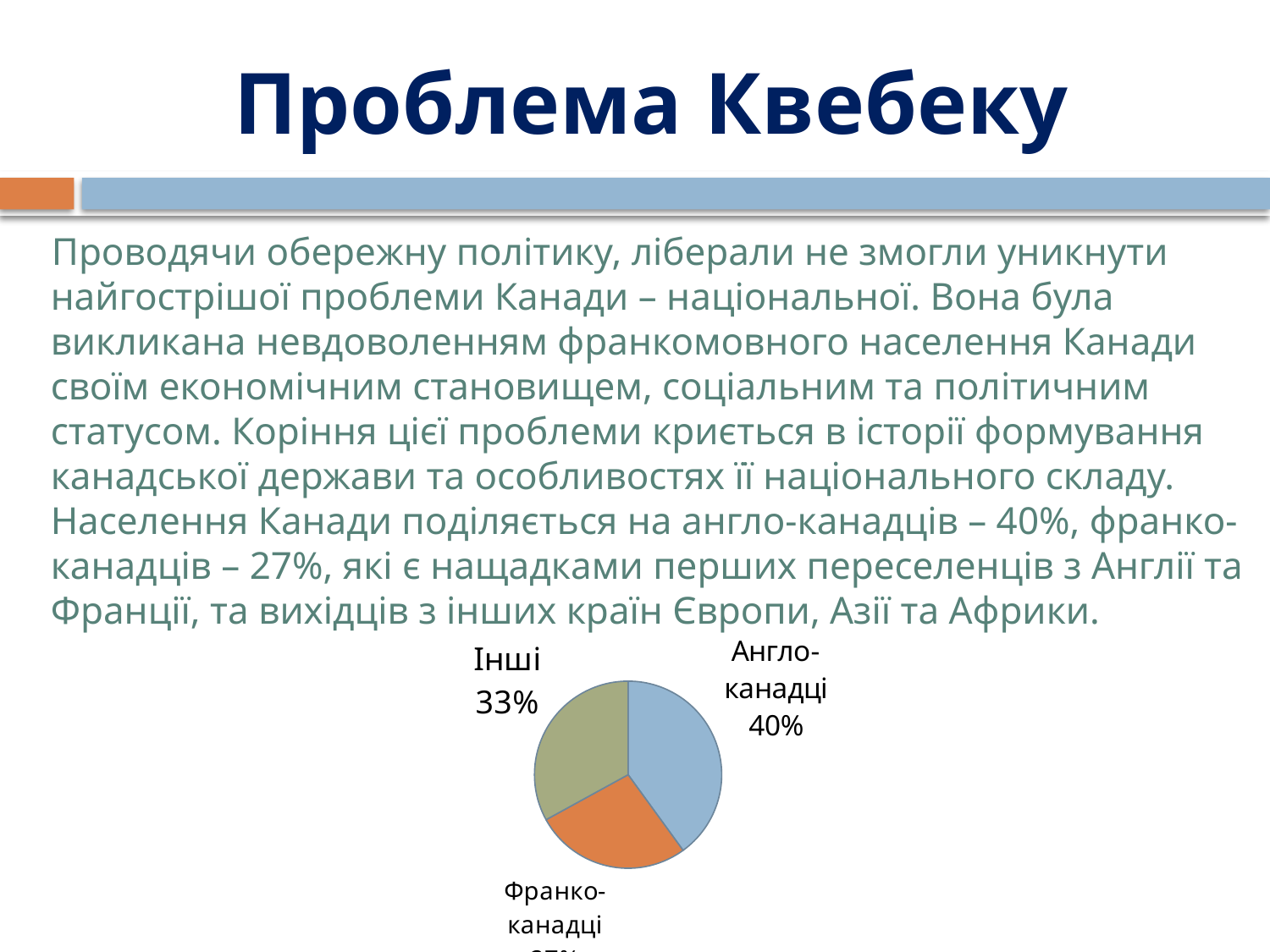
What percentage does the pie chart show for Англо-канадці? 40% What is the difference in percentage points between Англо-канадці and Інші in the pie chart? 7 What share of the pie does the Англо-канадці slice represent? 40% Which category is shown in orange in the pie chart? Франко-канадці What percentage does the pie chart show for Інші? 33% What colour is the Англо-канадці slice in the pie chart? blue Which is larger in the pie chart, Англо-канадці or Інші? Англо-канадці Which slice of the pie chart is the largest? Англо-канадці Which slice of the pie chart is the smallest? Франко-канадці What kind of chart is shown on the slide? pie chart How many slices does the pie chart have? 3 What percentage of the population are Франко-канадці according to the slide? 27%